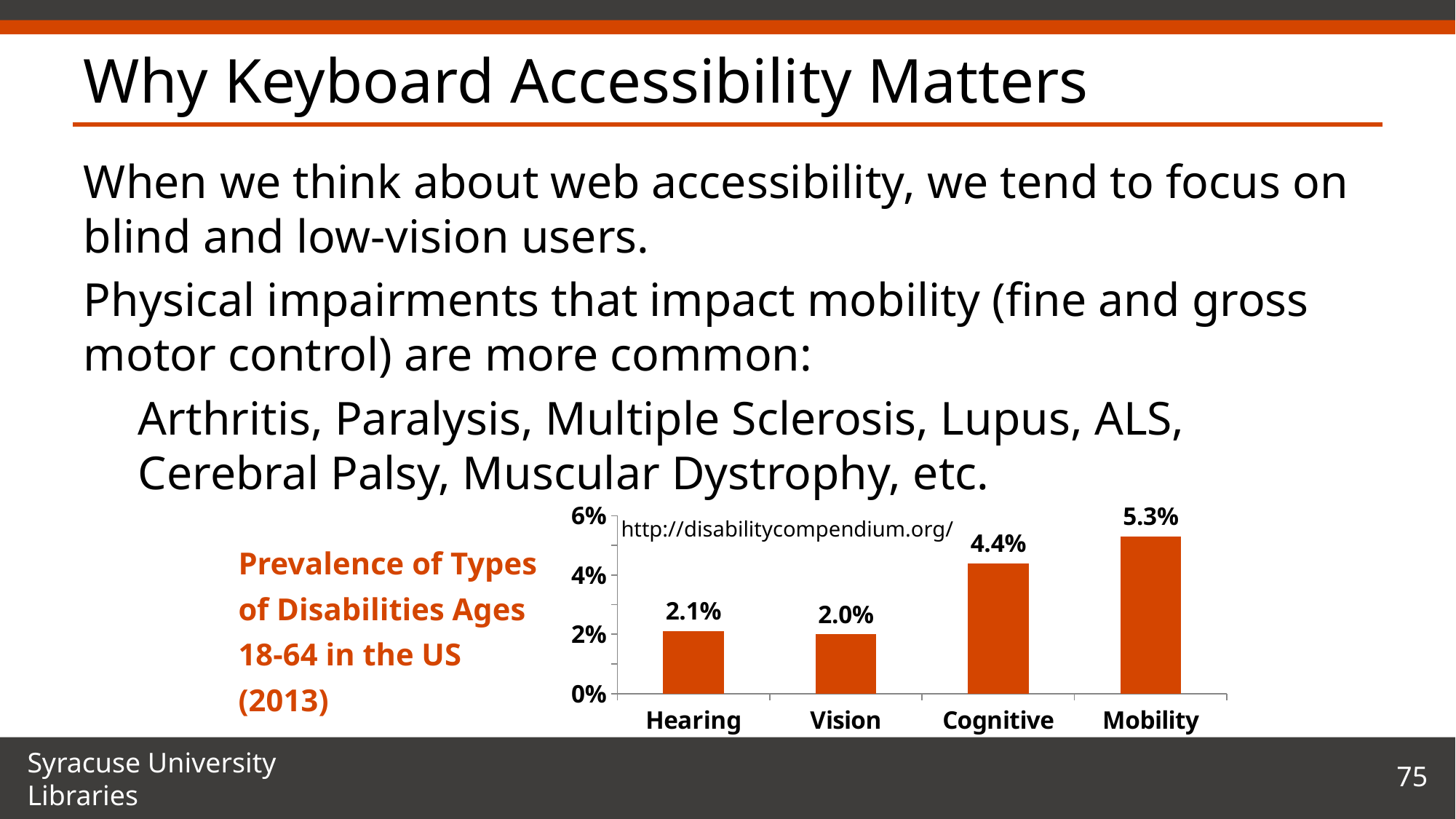
What is the value for Cognitive? 4.4% What is the title of the chart? Prevalence of Types of Disabilities Ages 18-64 in the US (2013) What kind of chart is shown on the slide? bar chart How many categories are shown in the chart? 4 What is the value for Hearing? 2.1% What is the value for Vision? 2.0% Which category has the lowest value? Vision What is the value for Mobility? 5.3% Which category has the highest value? Mobility Which is larger, the value for Cognitive or the value for Hearing? Cognitive Is the value for Cognitive greater or less than 4%? greater What is the difference between the values for Mobility and Cognitive? 0.9%